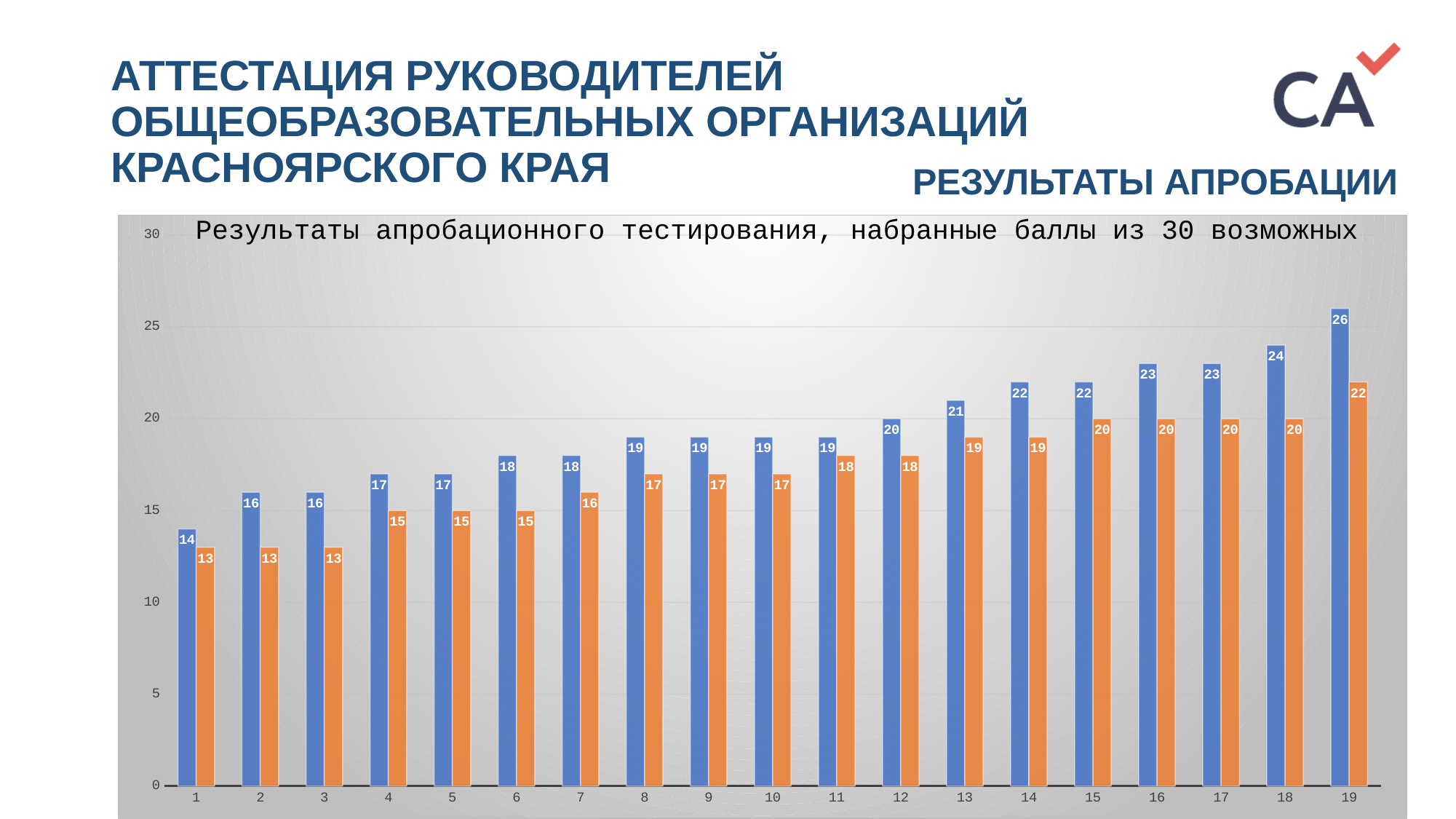
How many categories are shown on the x axis of the chart? 19 Which category has the highest blue bar? 19 What is the value of the blue bar for category 1? 14 Which category has the lowest blue bar? 1 What is the title of the chart? Результаты апробационного тестирования, набранные баллы из 30 возможных What type of chart is shown on the slide? bar chart What is the value of the orange bar for category 7? 16 What is the difference between the blue and orange bars for category 13? 2 Do the blue bar values generally rise or fall from category 1 to category 19? rise What is the difference between the blue bar for category 19 and the blue bar for category 1? 12 Which is larger for category 10: the blue bar or the orange bar? the blue bar What is the value of the orange bar for category 19? 22